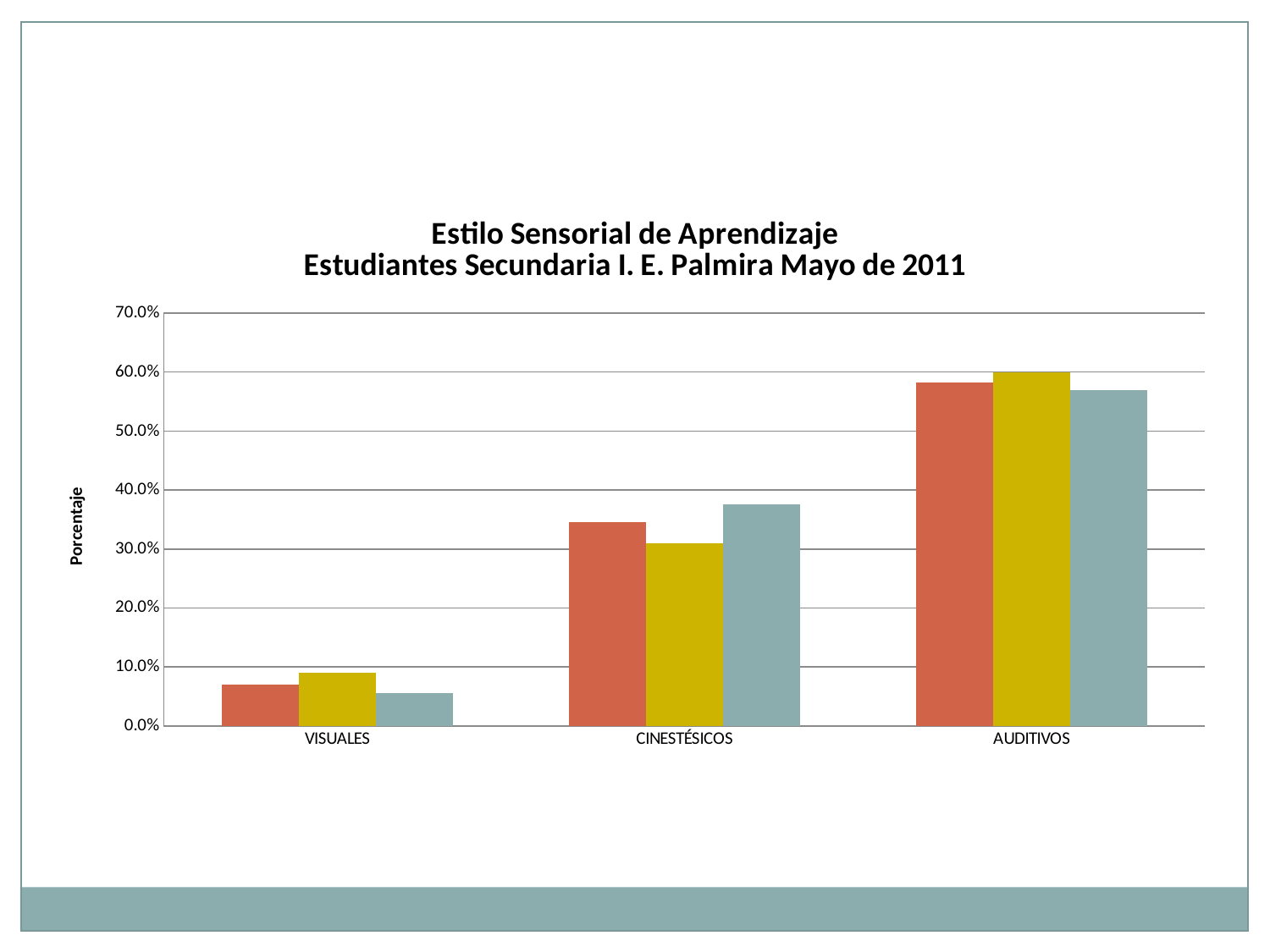
How many categories are shown on the x axis of the chart? 3 What kind of chart is shown on the slide? bar chart What is the title of the chart? Estilo Sensorial de Aprendizaje Estudiantes Secundaria I. E. Palmira Mayo de 2011 Is the value of the grey-blue bar for CINESTÉSICOS greater or less than 40.0%? less For VISUALES, which is larger: the yellow bar or the grey-blue bar? the yellow bar Which category has the lowest bars in the chart? VISUALES Which category has the highest bars in the chart? AUDITIVOS For CINESTÉSICOS, which is larger: the red bar or the grey-blue bar? the grey-blue bar Is the value of the red bar for VISUALES greater or less than 10.0%? less Is the value of the grey-blue bar for CINESTÉSICOS greater or less than 30.0%? greater What is the label on the vertical axis of the chart? Porcentaje